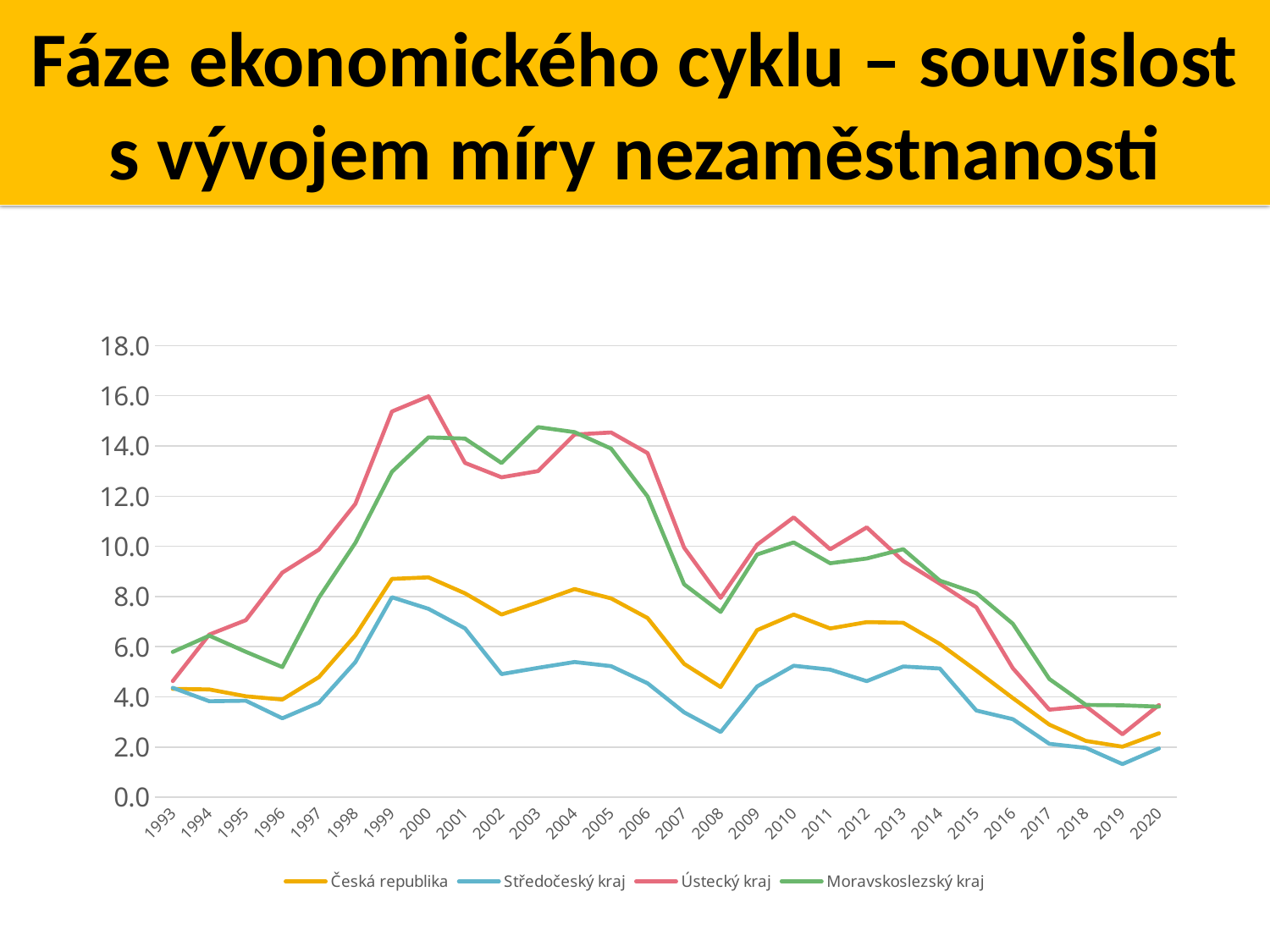
Which series has the lowest value in 2019? Středočeský kraj In which year does the Ústecký kraj line reach its highest value? 2000 Which is larger in 2005: Moravskoslezský kraj or Česká republika? Moravskoslezský kraj How many series does the legend list? 4 How many years are shown on the x axis? 28 Is the value for Ústecký kraj in 2000 greater or less than 14.0? greater Which series has the highest value in 2000? Ústecký kraj What kind of chart is shown on the slide? line chart Is the value for Středočeský kraj in 2019 greater or less than 2.0? less Does the Ústecký kraj line rise or fall from 2013 to 2019? fall Which series is drawn with the red line? Ústecký kraj Is the value for Moravskoslezský kraj in 2008 greater or less than 8.0? less